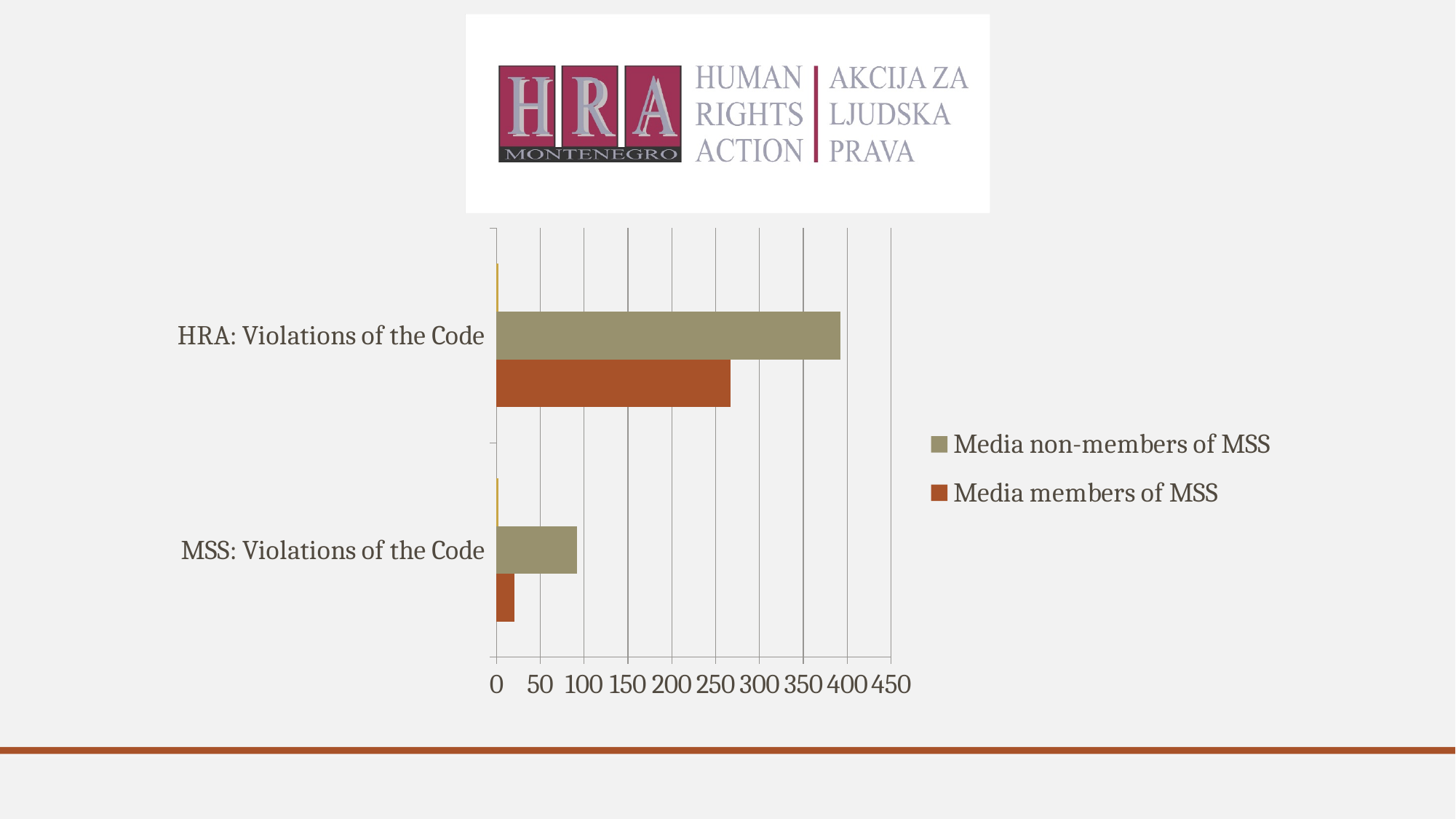
Is the value for Media members of MSS in the MSS: Violations of the Code category greater or less than 50? less Is the value for Media members of MSS in the HRA: Violations of the Code category greater or less than 250? greater Which category has the highest value for Media non-members of MSS? HRA: Violations of the Code In the HRA: Violations of the Code category, which series has the larger value, Media non-members of MSS or Media members of MSS? Media non-members of MSS Which category has the lowest value for Media members of MSS? MSS: Violations of the Code What kind of chart is shown on the slide? bar chart Which series is larger in the MSS: Violations of the Code category, Media members of MSS or Media non-members of MSS? Media non-members of MSS How many categories are shown on the vertical axis? 2 Is the value for Media non-members of MSS in the HRA: Violations of the Code category greater or less than 350? greater How many series does the legend list? 2 What colour represents the Media members of MSS series in the legend? orange-brown